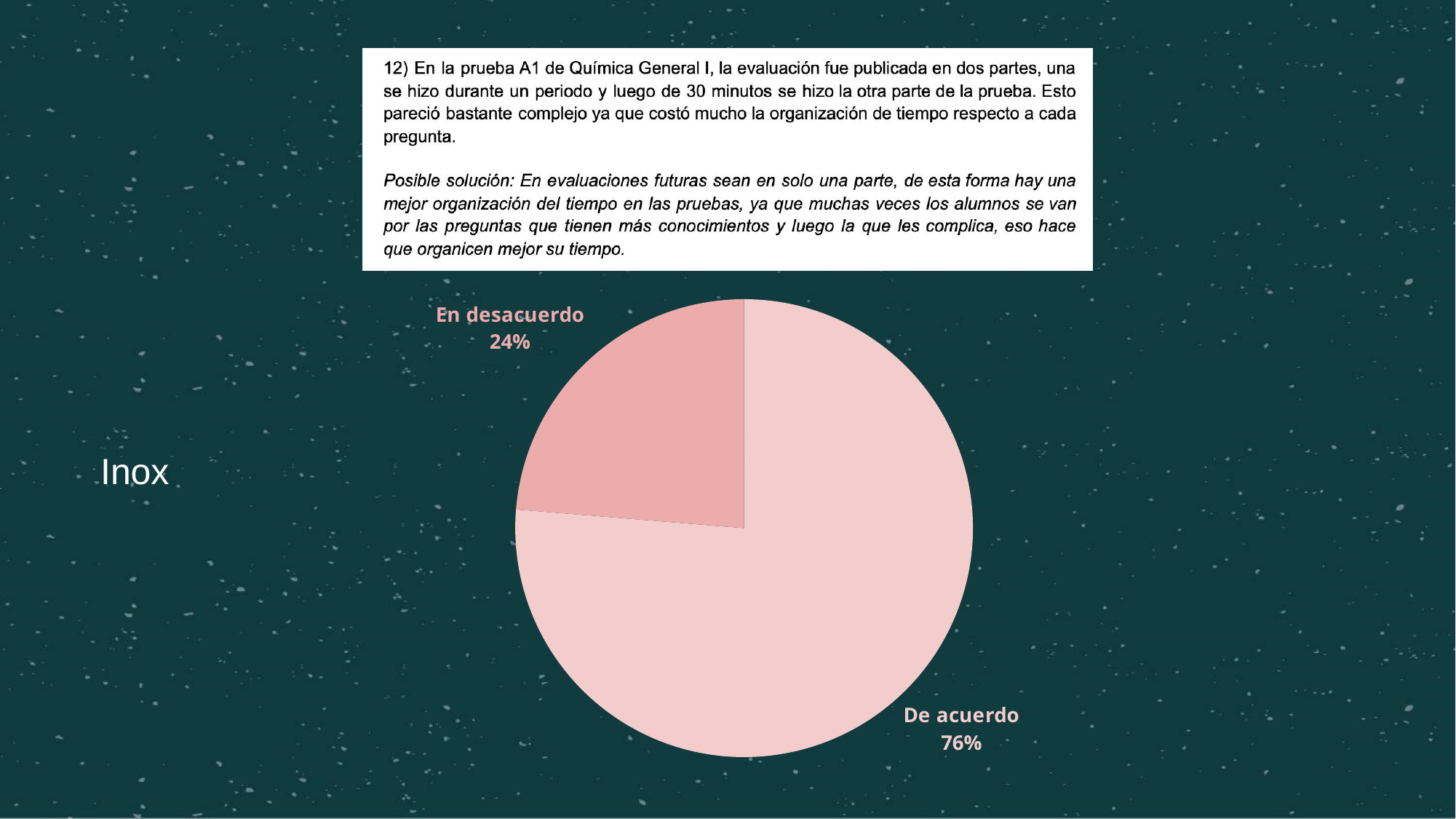
How many slices does the pie chart have? 2 What is the total of the two slices shown in the pie chart? 100% Is the share for "De acuerdo" greater or less than 50%? greater Which is larger, "De acuerdo" or "En desacuerdo"? De acuerdo Is the share for "En desacuerdo" greater or less than 25%? less Which slice of the pie chart is the smallest? En desacuerdo What share of the pie does "De acuerdo" represent? 76% What share of the pie does "En desacuerdo" represent? 24% What word appears to the left of the pie chart on the slide? Inox What is the difference in percentage points between "De acuerdo" and "En desacuerdo"? 52 Which slice of the pie chart is the largest? De acuerdo What kind of chart is shown on the slide? Pie chart